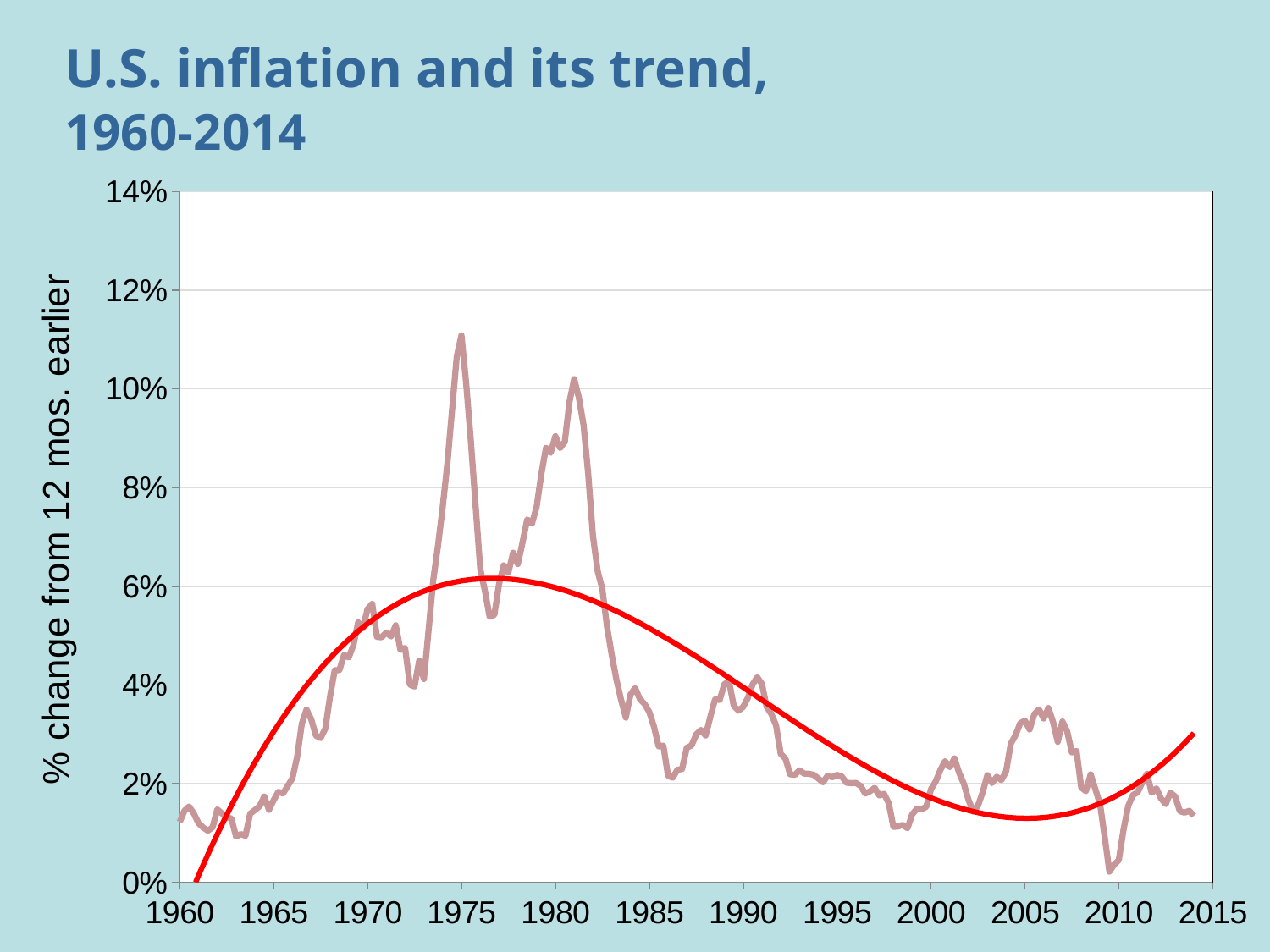
Does the smooth red trend line rise or fall between 1960 and 1975? rise What kind of chart is shown on the slide? line chart What is the title of the chart? U.S. inflation and its trend, 1960-2014 How many lines are plotted on the chart? 2 Is the inflation value at its lowest point around 2009-2010 greater or less than 2%? less Is the inflation value in 1960 greater or less than 2%? less Is the smooth red trend line at 2014 greater or less than 2%? greater Does the smooth red trend line rise or fall between 1980 and 2005? fall What is the label on the vertical axis? % change from 12 mos. earlier Which peak of the inflation line is higher, the one around 1975 or the one around 1980? around 1975